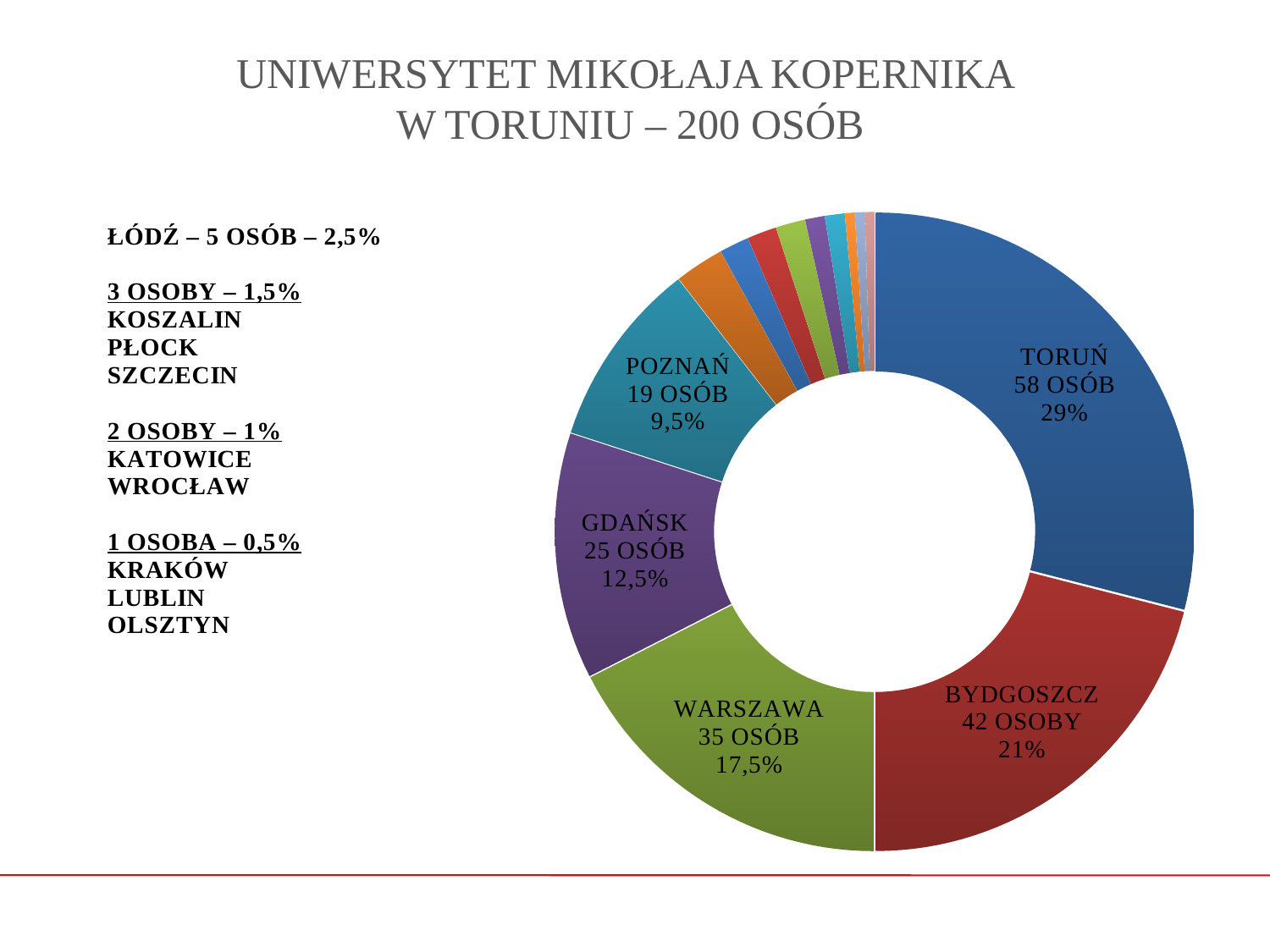
Which city has the largest slice of the chart? TORUŃ How many more people are in the Toruń slice than in the Bydgoszcz slice? 16 According to the slide title, how many people in total does the chart represent? 200 OSÓB What percentage is shown for the Poznań slice? 9,5% Which slice is larger, Warszawa or Gdańsk? WARSZAWA What share of the chart does the Gdańsk slice represent? 12,5% What percentage is shown for the Bydgoszcz slice? 21% How many people does the Toruń slice represent? 58 OSÓB What kind of chart is shown on the slide? doughnut chart What is the title of the slide? UNIWERSYTET MIKOŁAJA KOPERNIKA W TORUNIU – 200 OSÓB How many slices have labels printed inside the chart? 5 How many more people are in the Warszawa slice than in the Gdańsk slice? 10